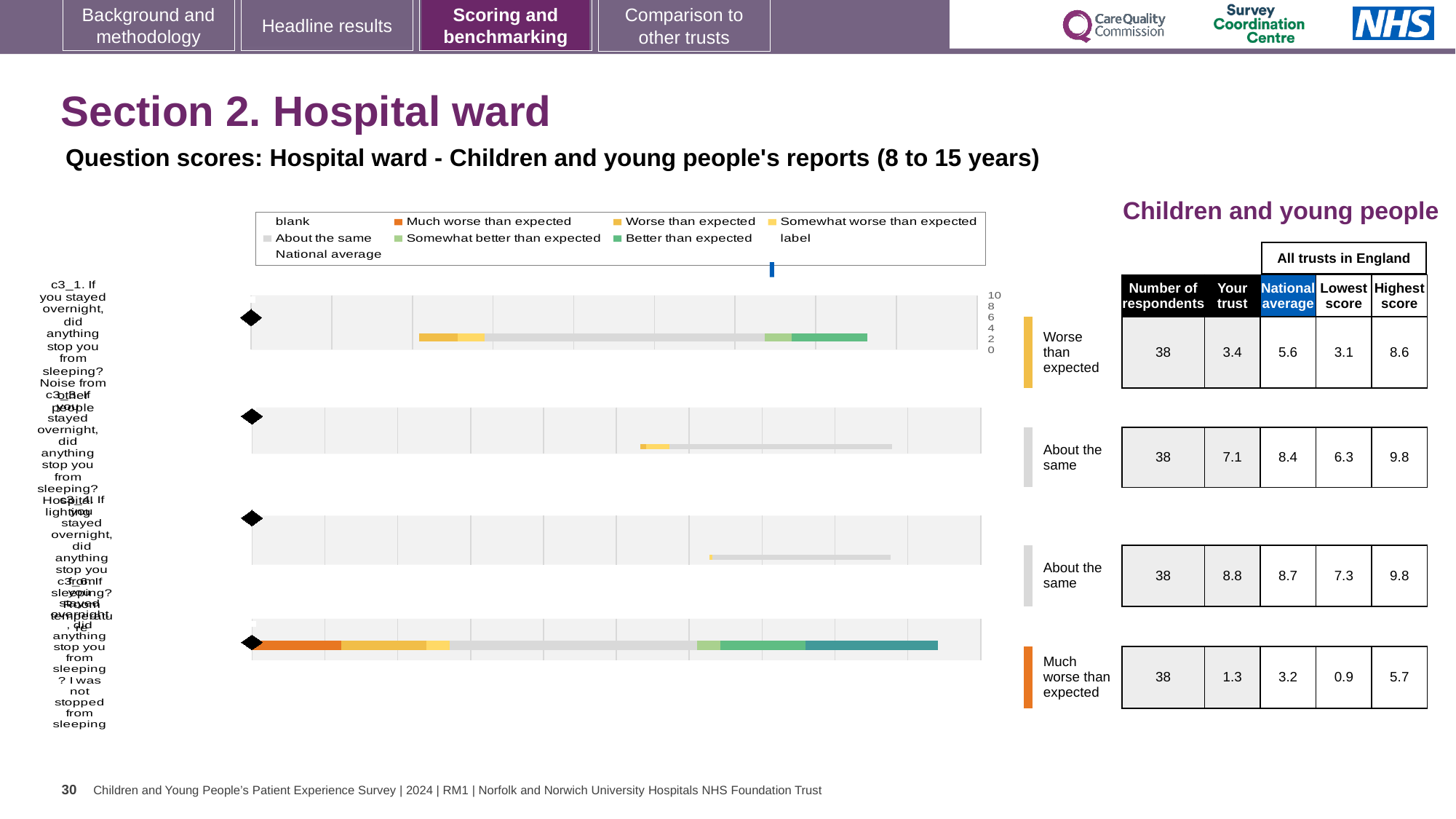
How many question rows are plotted in the chart? 4 What kind of chart is used to show the question scores on this slide? bar chart What colour represents 'Much worse than expected' in the legend? orange How many respondents are reported for each question row? 38 What benchmark category is shown for the fourth (bottom) question row? Much worse than expected Which question row has the highest 'Your trust' score? the third row (8.8) For the second question row, which is larger: the 'Your trust' score or the national average? the national average What is the highest score across all trusts in England for the second question row? 9.8 Which question row has the lowest 'Your trust' score? the fourth row (1.3) For the first question row, how much higher is the national average than the 'Your trust' score? 2.2 What is the 'Your trust' score for the first (top) question row, c3_1 about noise from other people? 3.4 What is the national average for the fourth (bottom) question row, c3_6? 3.2